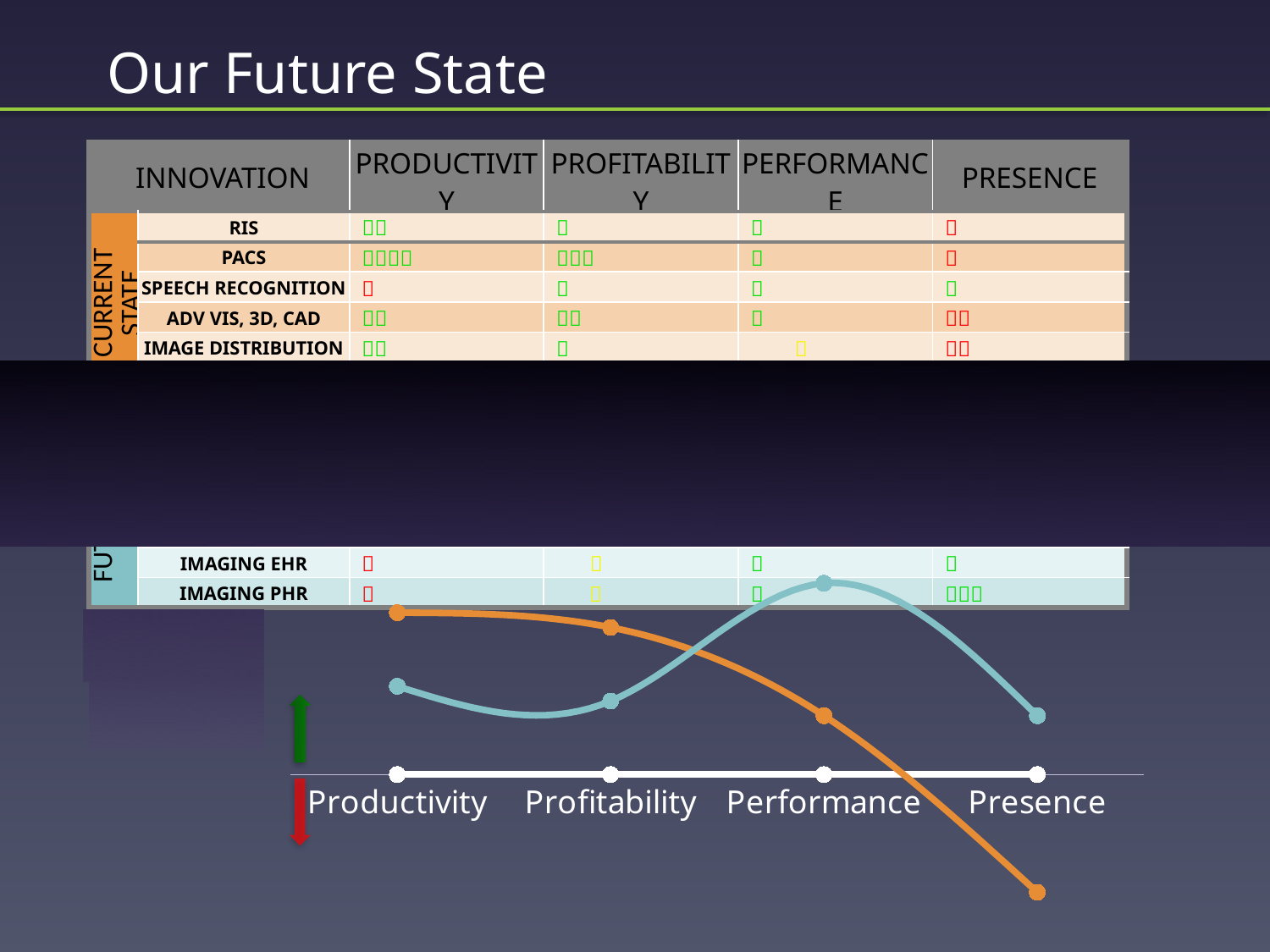
At which category does the blue line reach its highest point? Performance At Productivity, which line is higher, the orange line or the blue line? orange At Presence, which line is higher, the orange line or the blue line? blue What kind of chart is shown at the bottom of the slide? line chart At which category does the orange line reach its lowest point? Presence For the orange line, which is higher, the value at Performance or the value at Presence? Performance What are the four categories on the x axis of the line chart, from left to right? Productivity, Profitability, Performance, Presence Does the blue line rise or fall between Profitability and Performance? rise Does the orange line rise or fall as it moves from Productivity to Presence? fall What two colours are used for the curved lines in the chart? orange and blue How many categories are labelled on the x axis of the line chart? 4